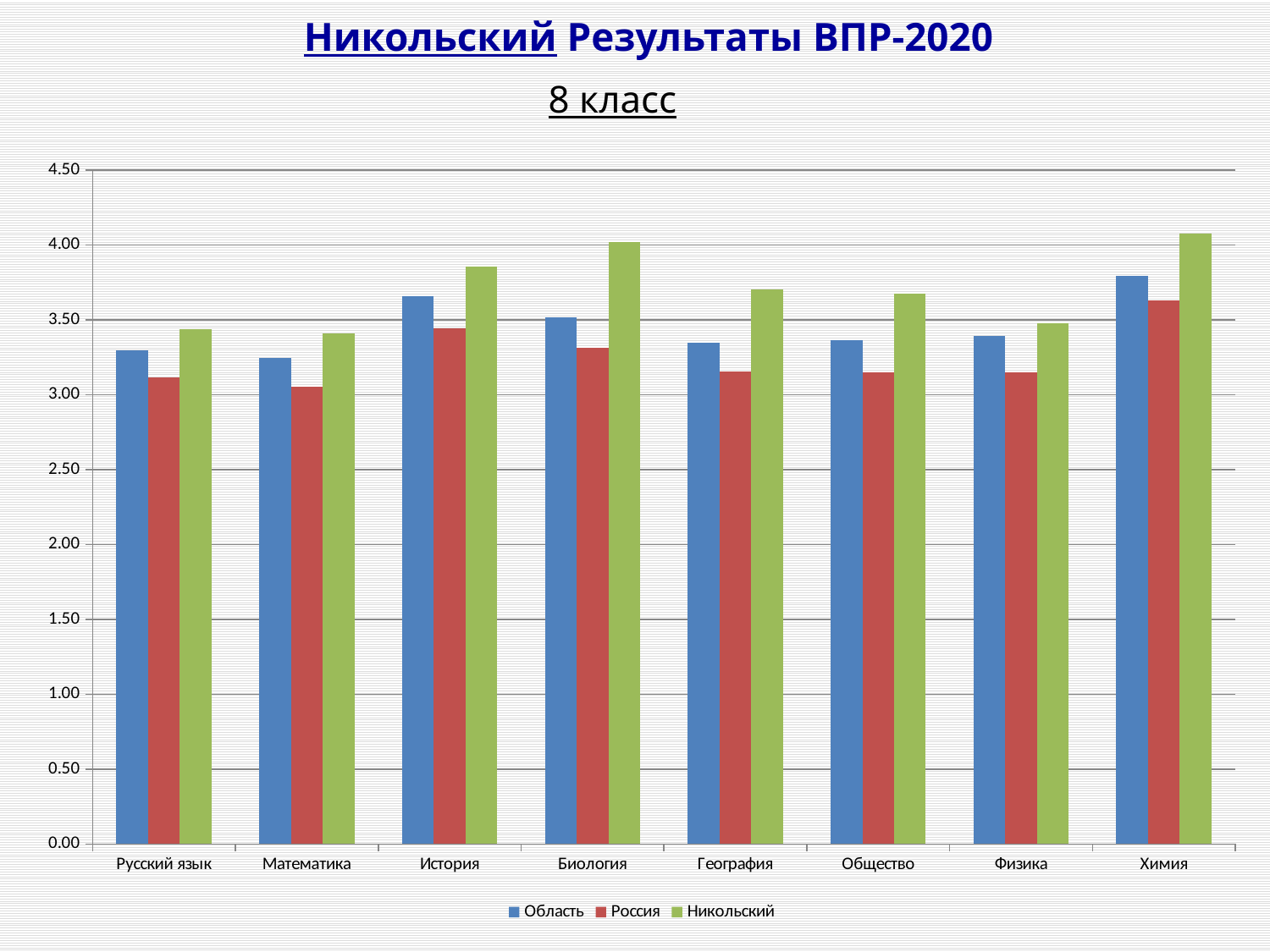
Which series is shown in green in the legend? Никольский Is the value for Область in История greater or less than 3.50? greater In Химия, which is larger: the value for Область or the value for Россия? Область Which subject has the lowest value for the Россия series? Математика Is the value for Никольский in Биология greater or less than 4.00? greater What kind of chart is shown on the slide? bar chart Is the value for Россия in География greater or less than 3.50? less How many subjects (categories) are shown on the x axis? 8 In Биология, which is larger: the value for Никольский or the value for Область? Никольский Which subject has the highest value for the Область series? Химия How many series does the legend list? 3